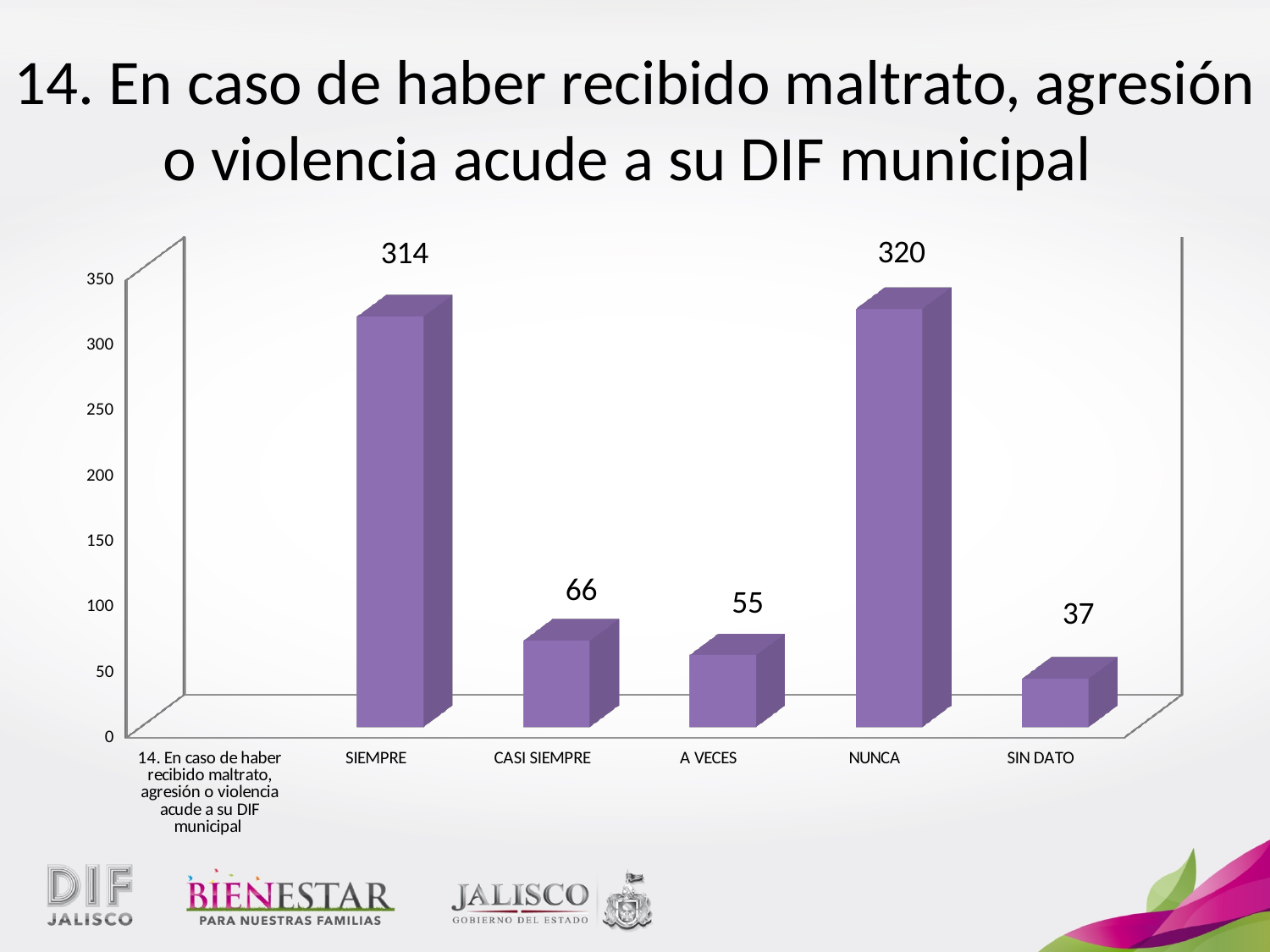
What is the value for SIEMPRE? 314 What is the difference between the values for CASI SIEMPRE and A VECES? 11 What is the value for SIN DATO? 37 What is the value for NUNCA? 320 Is the value for SIN DATO greater or less than 50? less Which is larger, the value for CASI SIEMPRE or the value for A VECES? CASI SIEMPRE What is the value for A VECES? 55 What is the difference between the values for NUNCA and SIEMPRE? 6 Which category has the highest value? NUNCA What kind of chart is shown on the slide? bar chart How many bars are plotted in the chart? 5 Which category has the lowest value? SIN DATO